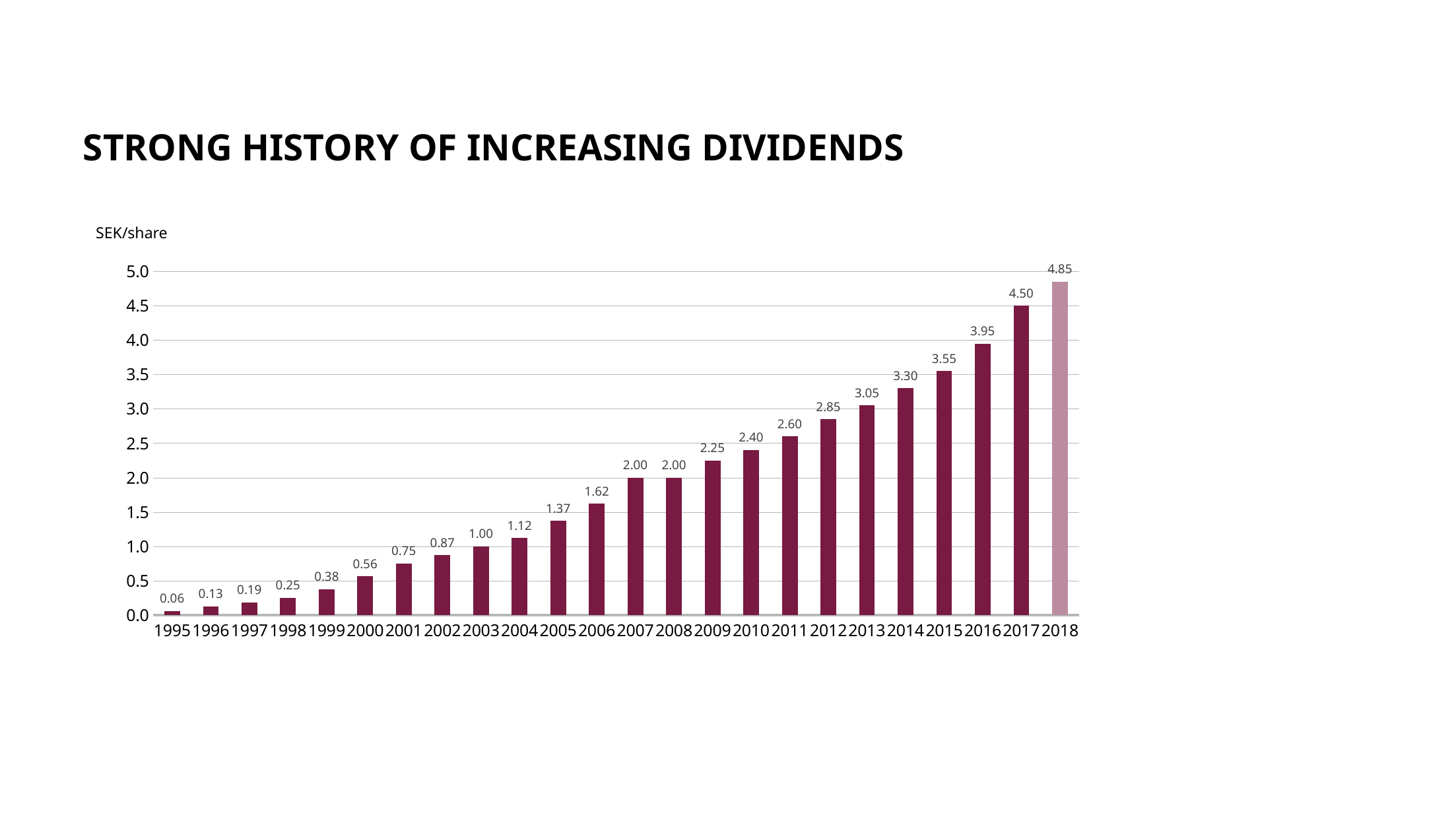
What is the difference between the dividend per share in 2018 and in 1995? 4.79 What is the dividend per share for 1999? 0.38 Do the dividend values generally rise or fall from 1995 to 2018? Rise Which year has the lowest dividend per share? 1995 What kind of chart is shown on the slide? Bar chart What is the difference between the dividend per share in 2017 and in 2016? 0.55 How many years are shown on the x axis? 24 Which year has the highest dividend per share? 2018 Which year has a larger dividend per share, 2005 or 2012? 2012 What unit is shown above the y axis of the chart? SEK/share What is the dividend per share for 2018? 4.85 What is the dividend per share for 2010? 2.40